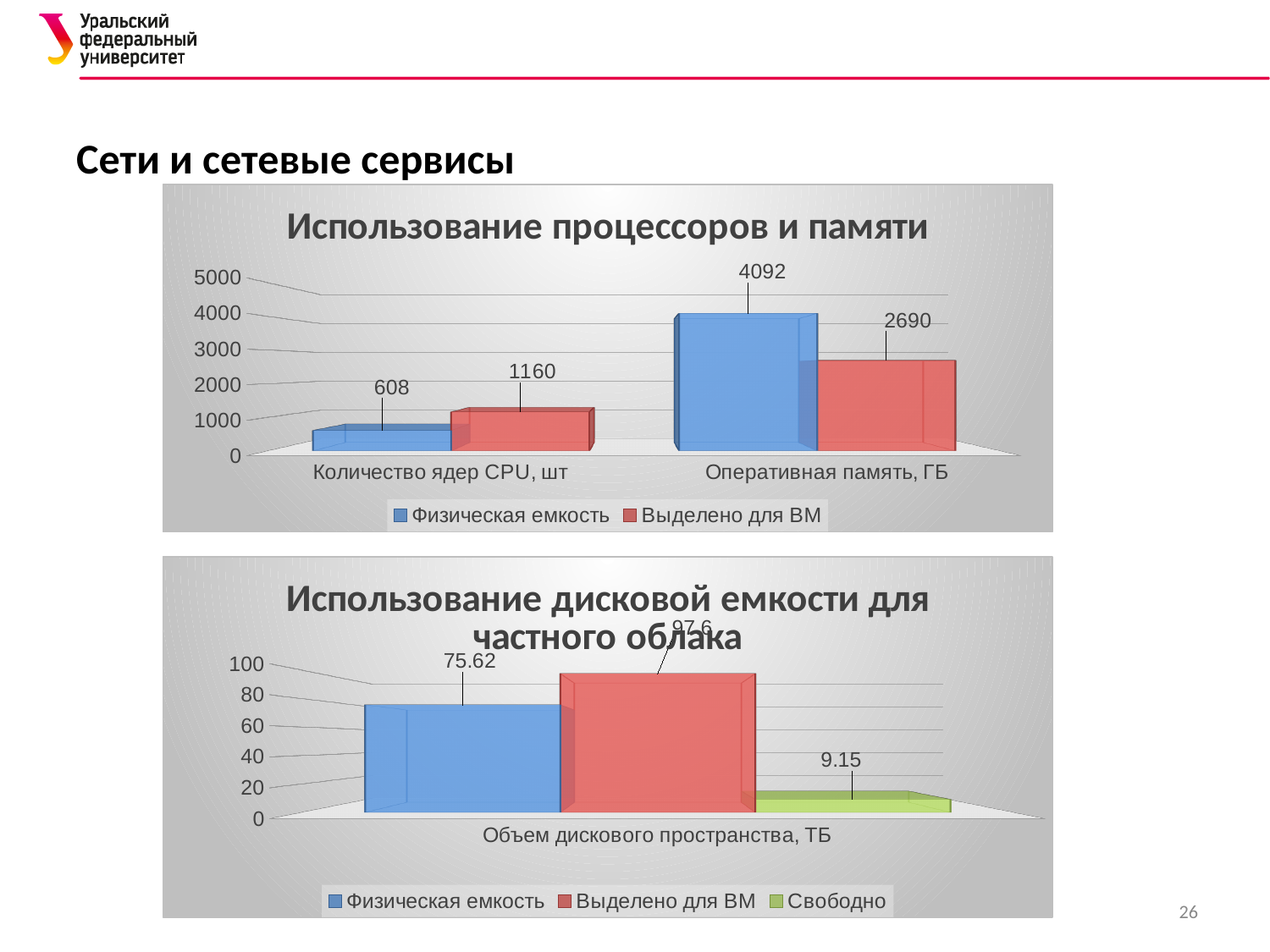
In the chart 'Использование процессоров и памяти', what is the value of 'Выделено для ВМ' for 'Оперативная память, ГБ'? 2690 What kind of chart is the bottom chart on the slide? Bar chart In the chart 'Использование процессоров и памяти', what is the difference between 'Физическая емкость' and 'Выделено для ВМ' for 'Оперативная память, ГБ'? 1402 In the chart 'Использование процессоров и памяти', how many categories are shown on the x axis? 2 In the chart 'Использование дисковой емкости для частного облака', which series has the lowest value? Свободно In the chart 'Использование процессоров и памяти', which bar has the highest value? Физическая емкость for Оперативная память, ГБ (4092) In the chart 'Использование дисковой емкости для частного облака', what is the value of 'Выделено для ВМ'? 97.6 In the chart 'Использование дисковой емкости для частного облака', how many series does the legend list? 3 In the chart 'Использование процессоров и памяти', what is the value of 'Физическая емкость' for 'Количество ядер CPU, шт'? 608 In the chart 'Использование процессоров и памяти', which series is larger for 'Количество ядер CPU, шт': 'Физическая емкость' or 'Выделено для ВМ'? Выделено для ВМ In the chart 'Использование процессоров и памяти', how many series does the legend list? 2 In the chart 'Использование дисковой емкости для частного облака', what is the value of 'Свободно'? 9.15